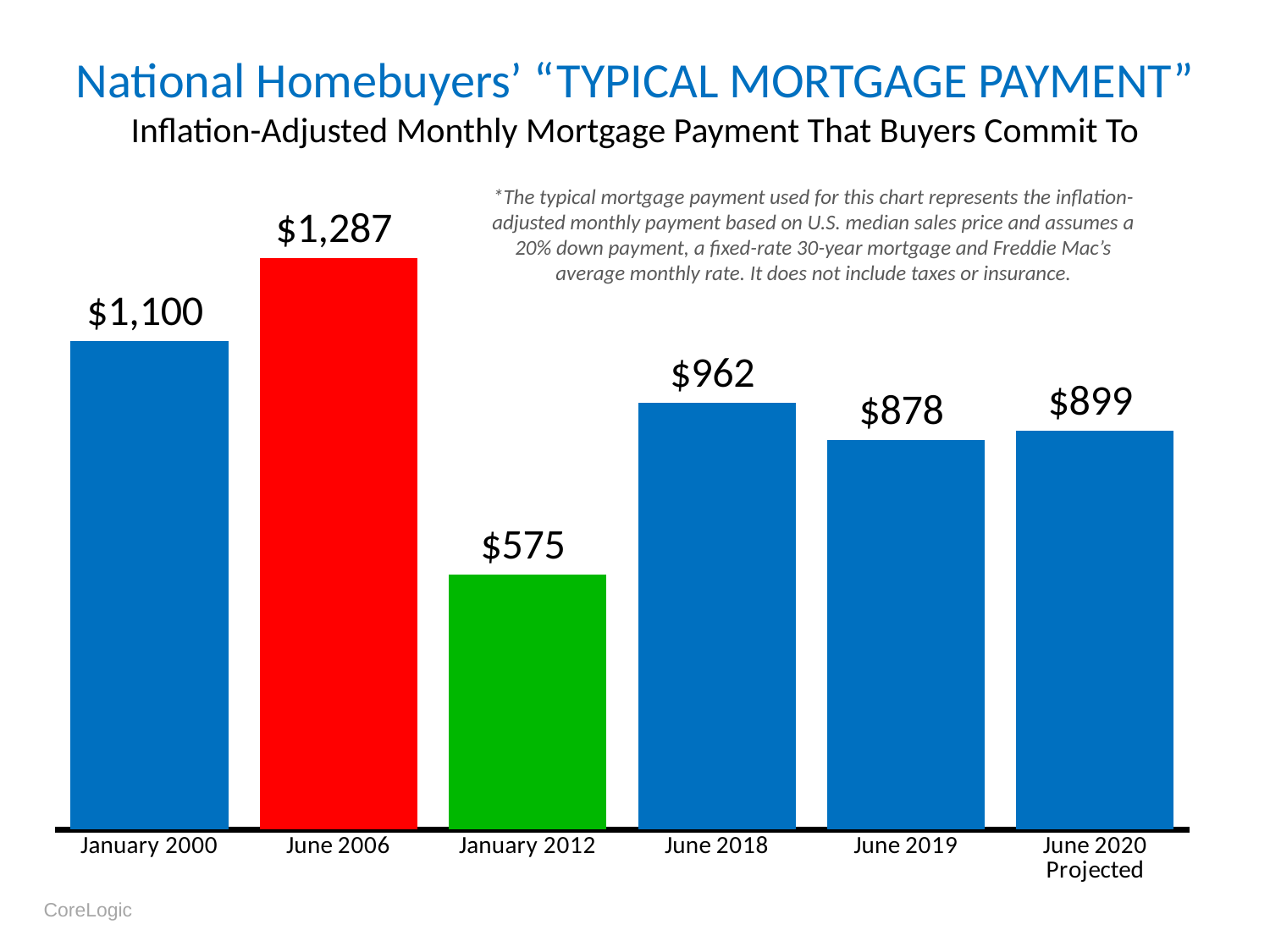
What is the typical mortgage payment for June 2019? $878 What is the typical mortgage payment for January 2012? $575 What is the typical mortgage payment for January 2000? $1,100 What is the projected typical mortgage payment for June 2020? $899 Which period has the lowest typical mortgage payment? January 2012 Which period has the highest typical mortgage payment? June 2006 What kind of chart is shown on the slide? Bar chart How many periods are shown on the chart? 6 What is the difference between the June 2006 and January 2012 typical mortgage payments? $712 Which is larger, the typical mortgage payment for June 2019 or June 2020 Projected? June 2020 Projected What is the difference between the June 2018 and June 2019 typical mortgage payments? $84 What is the typical mortgage payment for June 2006? $1,287